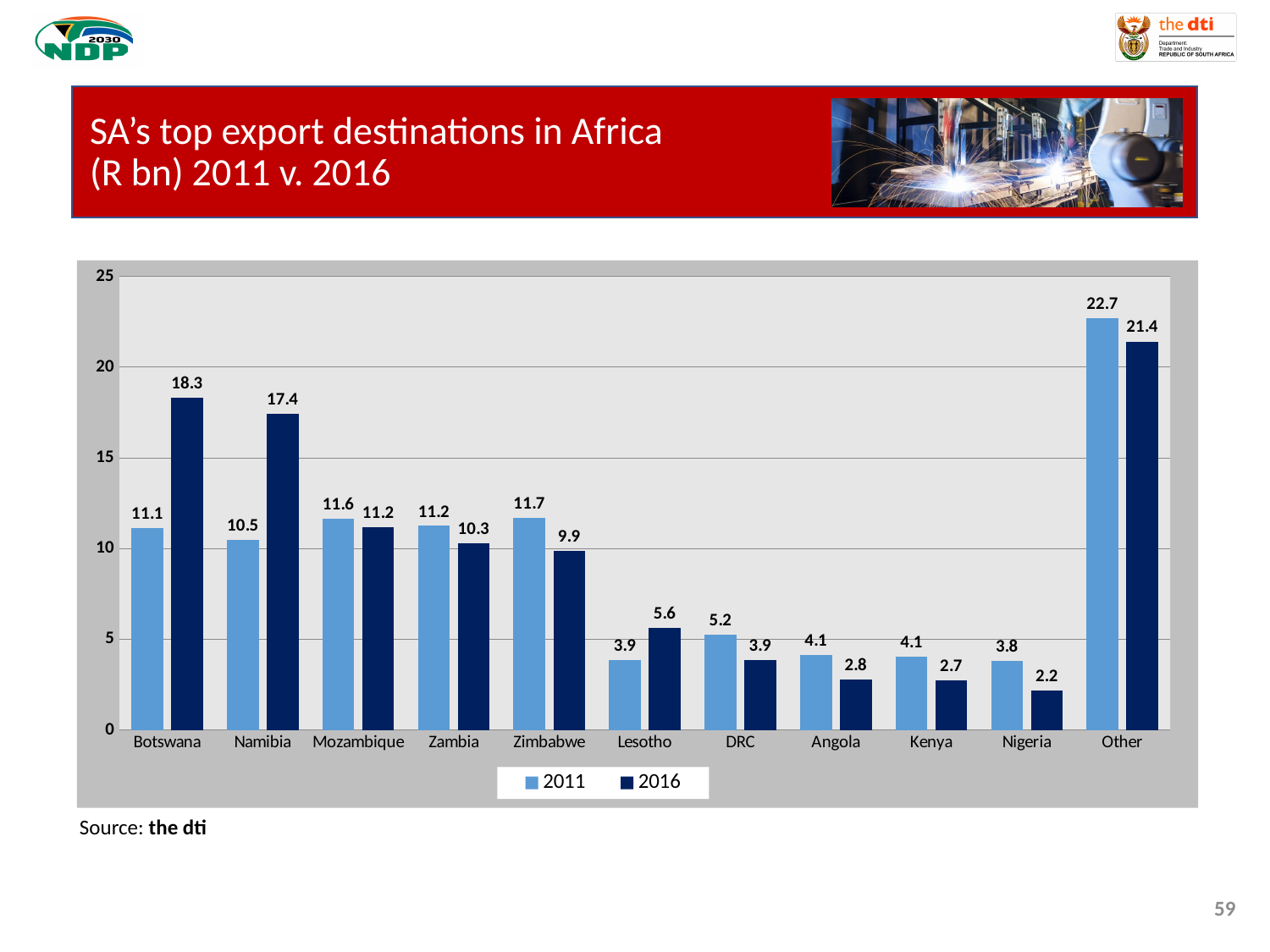
How many series does the legend list? 2 How many destination categories are shown on the x axis? 11 What is the difference between the 2016 and 2011 values for Namibia? 6.9 What is the source cited below the chart? the dti What kind of chart is shown on the slide? bar chart What was the value for Botswana in 2016? 18.3 Which is larger for Zimbabwe, the 2011 value or the 2016 value? 2011 Which destination had the lowest value in 2016? Nigeria What was the value for Namibia in 2011? 10.5 Excluding Other, which destination had the highest value in 2016? Botswana What was the value for Nigeria in 2016? 2.2 Is the 2011 value for Lesotho greater or less than 5? less